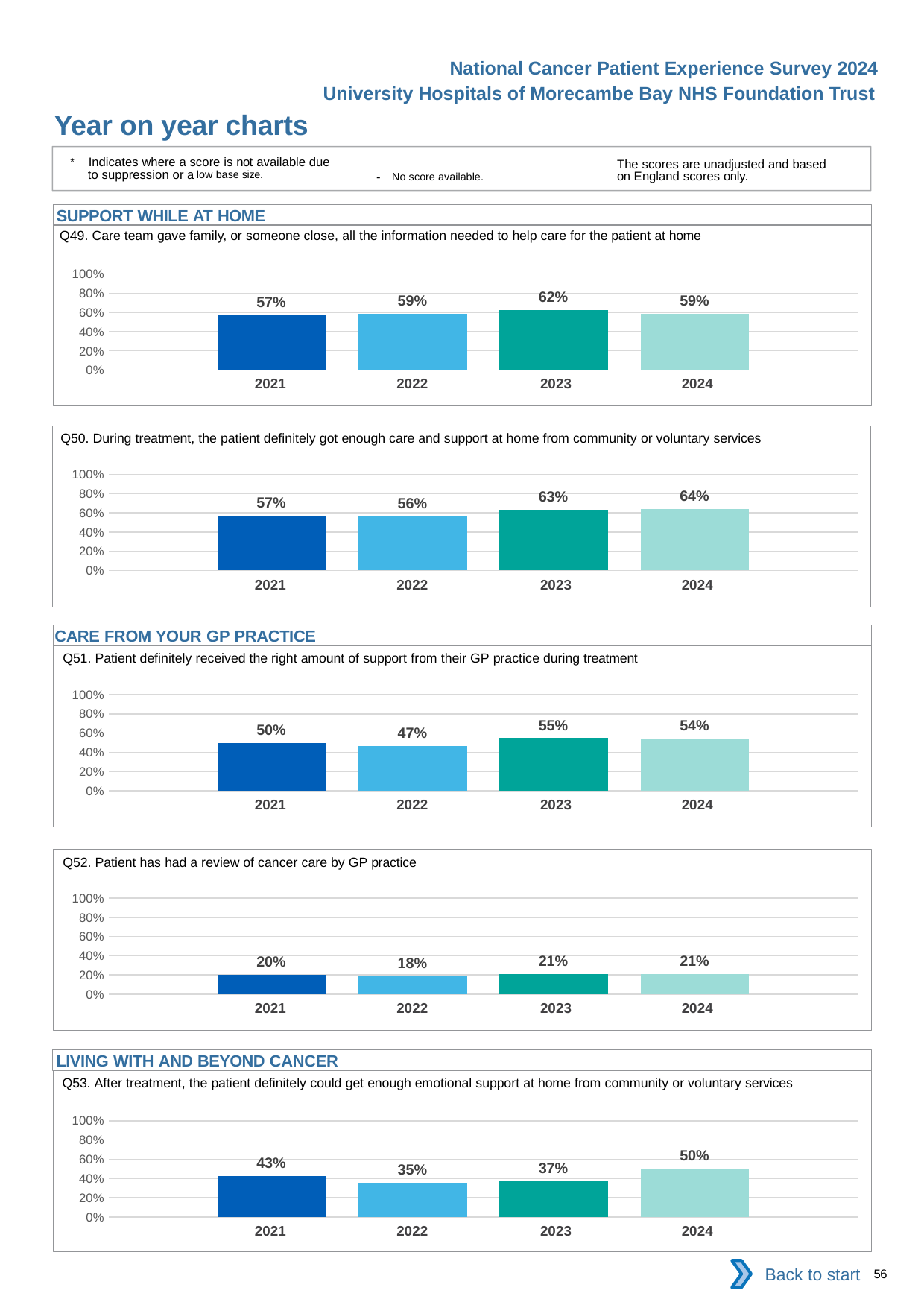
How many years are shown in the Q49 chart? 4 In the Q51 chart, what is the difference between the 2023 value and the 2021 value? 5% In the Q51 chart, which year has the lowest value? 2022 In the Q53 chart, is the value for 2024 greater or less than 40%? greater In the Q53 chart, what is the value for 2021? 43% In the Q50 chart, which is larger, the value for 2021 or the value for 2023? 2023 In the Q53 chart, what is the difference between the 2024 value and the 2022 value? 15% In the Q50 chart, which year has the highest value? 2024 What kind of chart is the Q52 chart? bar chart Which section heading appears above the Q51 chart? CARE FROM YOUR GP PRACTICE In the Q49 chart, what is the value for 2023? 62% In the Q52 chart, what is the value for 2022? 18%